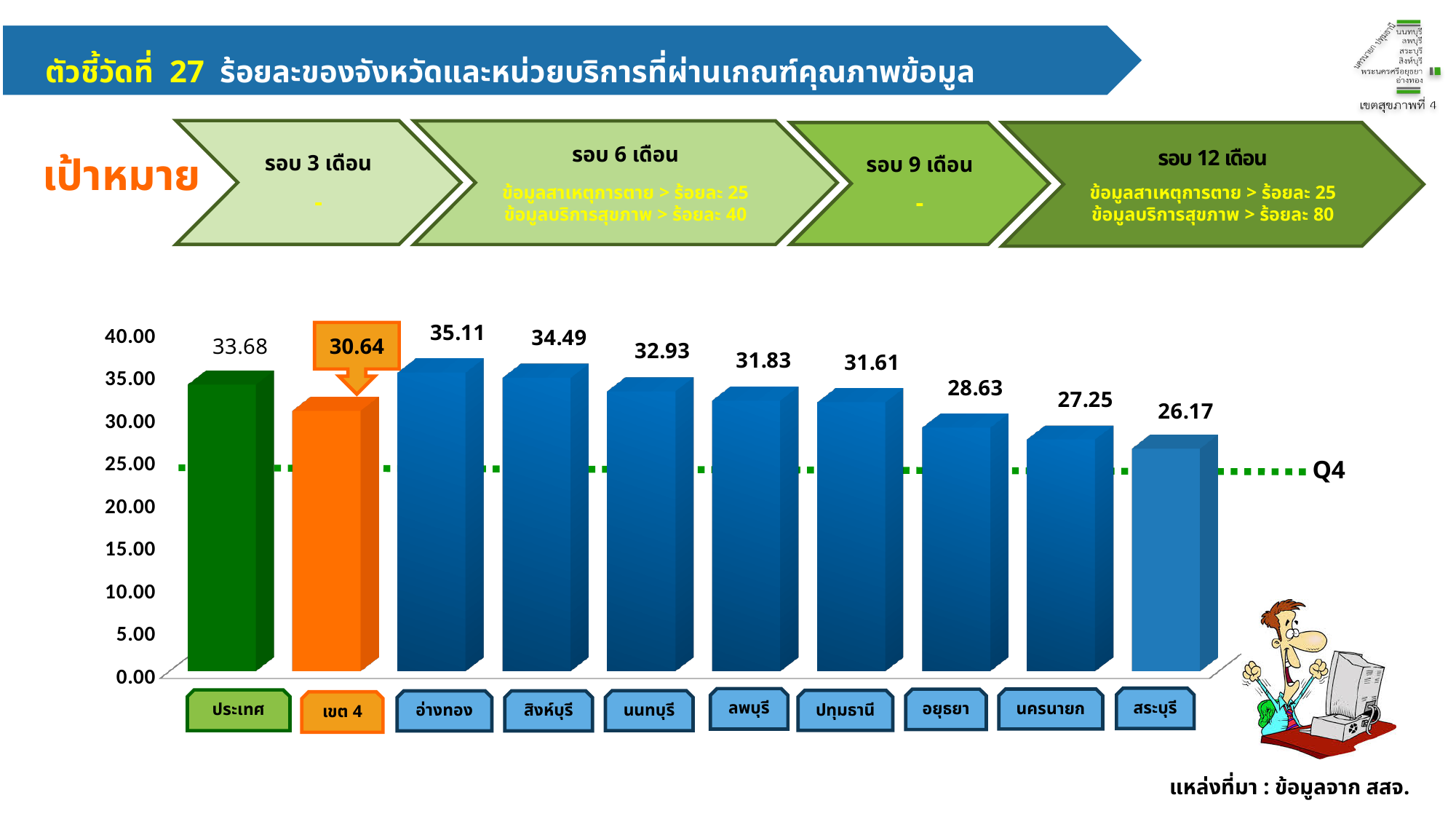
What is the difference between the values for ประเทศ and เขต 4? 3.04 Which category has the highest value? อ่างทอง Which is larger, the value for นนทบุรี or the value for อยุธยา? นนทบุรี What is the value for สระบุรี? 26.17 Which category has the lowest value? สระบุรี What is the value for ประเทศ? 33.68 What is the difference between the values for อ่างทอง and สระบุรี? 8.94 What kind of chart is shown on the slide? bar chart What is the value for เขต 4? 30.64 Is the value for นครนายก greater or less than 30.00? less How many categories are shown in the chart? 10 What is the value for อ่างทอง? 35.11